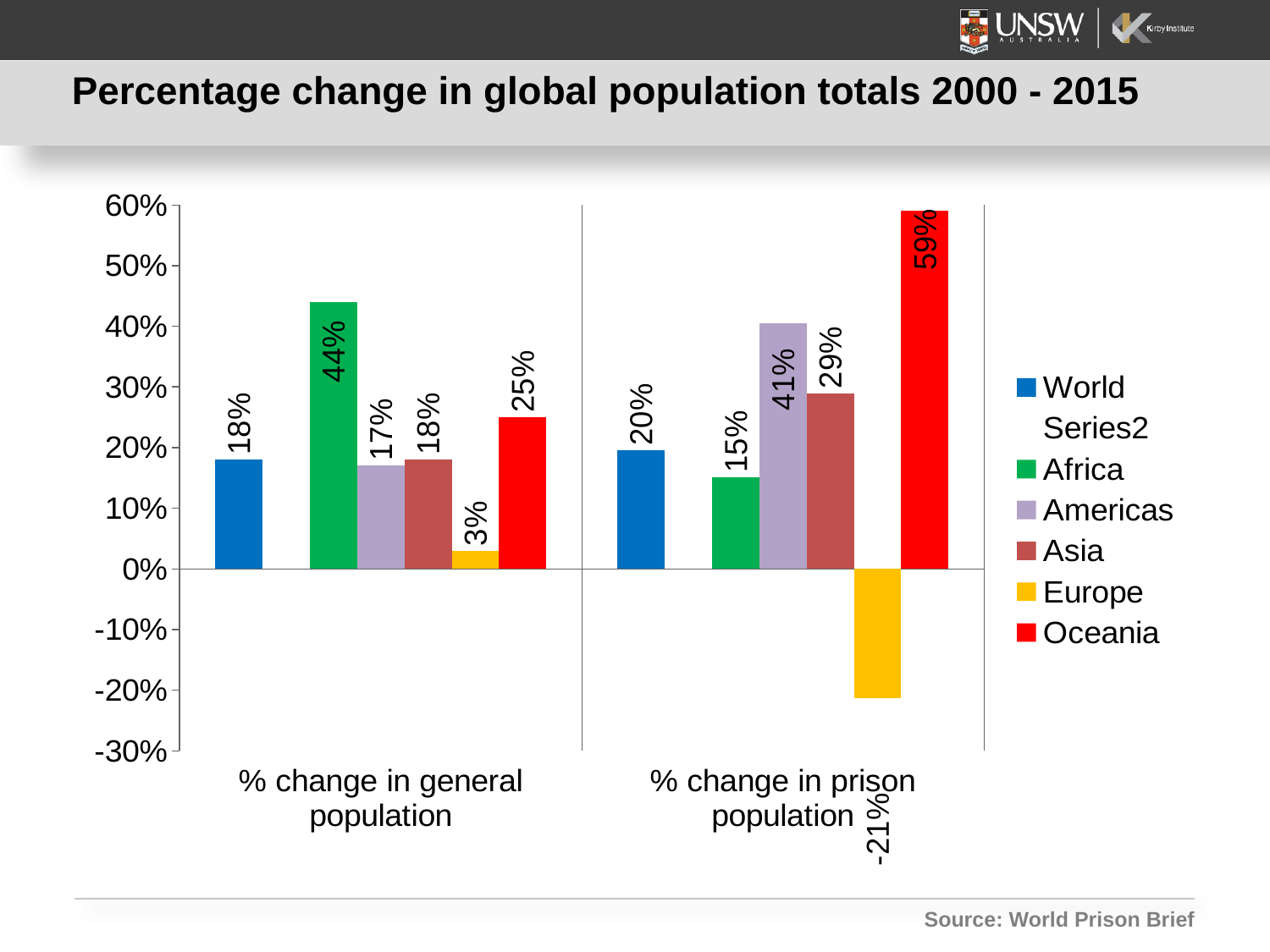
What is the value for World in the % change in prison population category? 20% What is the value for Africa in the % change in general population category? 44% Which series has the lowest value in the % change in prison population category? Europe What is the difference between the Oceania values for prison population and general population? 34% How many categories are shown on the x axis? 2 What is the value for Oceania in the % change in prison population category? 59% How many series does the legend list? 7 What kind of chart is shown on the slide? bar chart What is the value for Europe in the % change in prison population category? -21% Is the value for Asia in the % change in prison population category greater or less than 20%? greater Which is larger: the Americas value for general population or for prison population? prison population Which series has the highest value in the % change in general population category? Africa